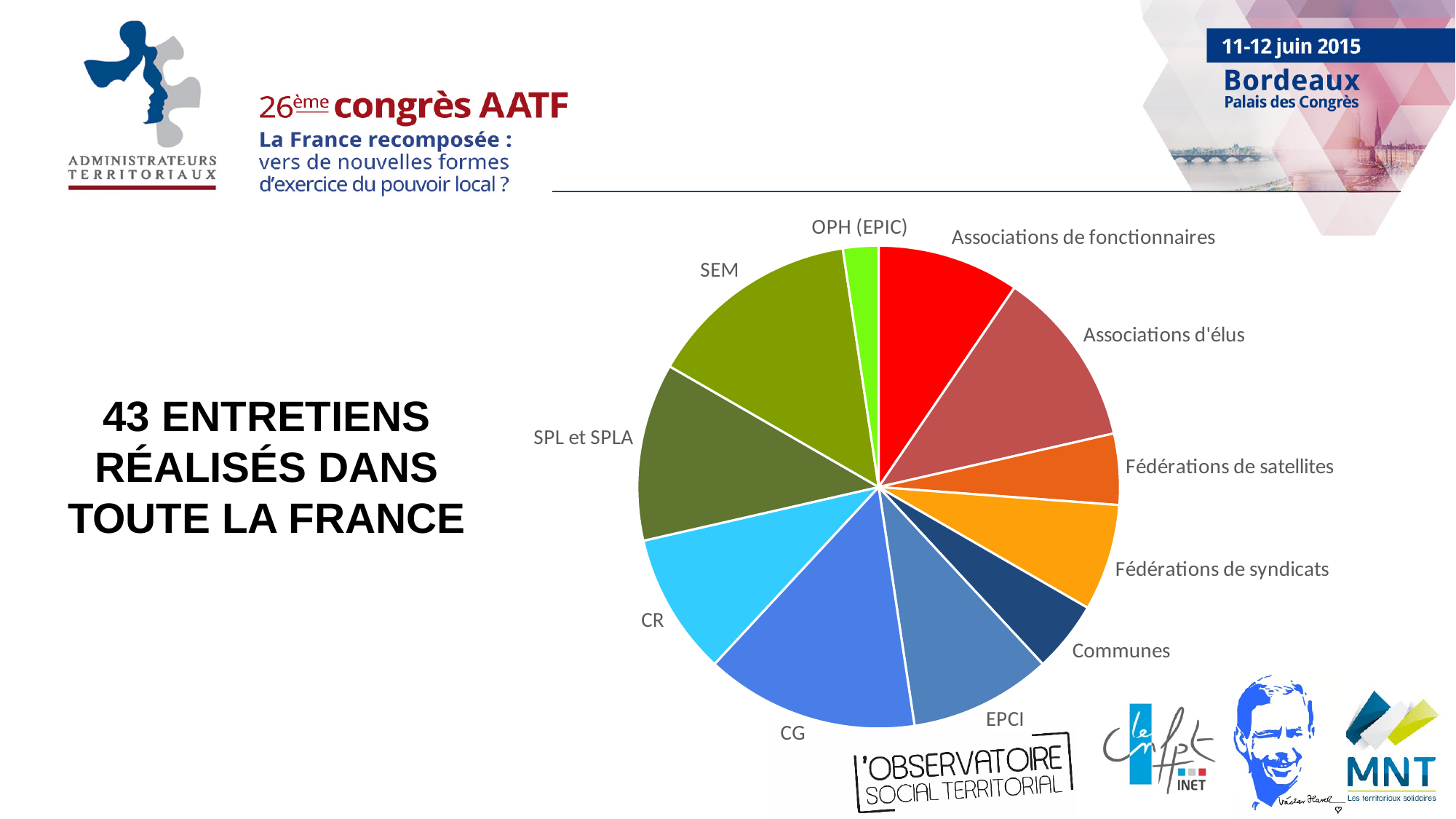
What colour is the slice for Associations de fonctionnaires? red Which slice is larger, Communes or CG? CG How many categories (slices) does the pie chart have? 11 What kind of chart is shown on the slide? pie chart Which slice is larger, OPH (EPIC) or Associations de fonctionnaires? Associations de fonctionnaires Which slice is larger, Communes or SEM? SEM Which category has the smallest slice in the pie chart? OPH (EPIC) According to the text next to the chart, how many interviews (entretiens) were carried out? 43